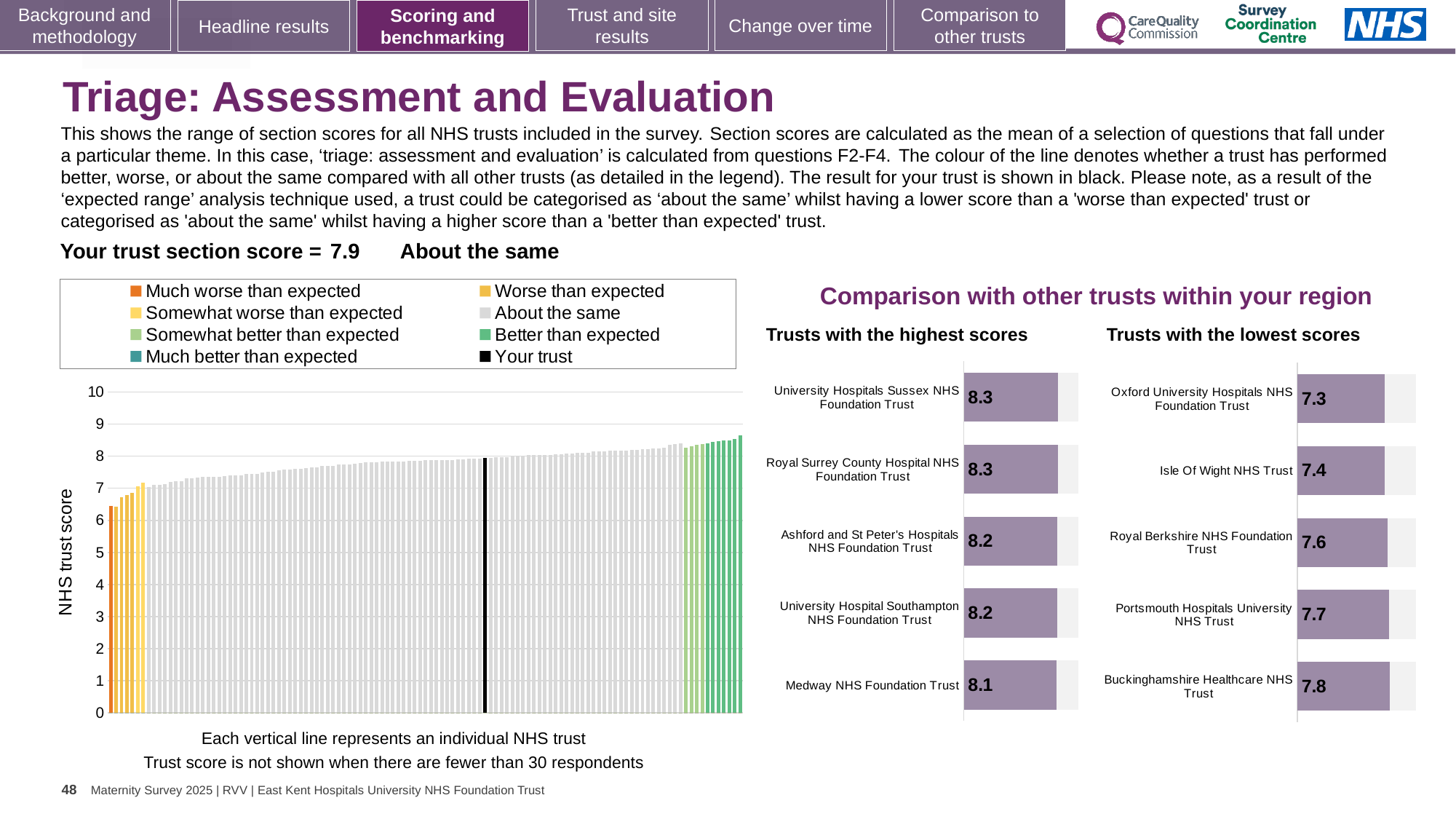
What kind of chart is the 'Trusts with the lowest scores' chart? Bar chart In the 'Trusts with the lowest scores' chart, what is the score for Oxford University Hospitals NHS Foundation Trust? 7.3 How many trusts are shown in the 'Trusts with the highest scores' chart? 5 In the 'Trusts with the lowest scores' chart, which has the larger score: Royal Berkshire NHS Foundation Trust or Portsmouth Hospitals University NHS Trust? Portsmouth Hospitals University NHS Trust In the left-hand chart of NHS trust scores, is the value of the leftmost (lowest) bar greater or less than 7? less In the 'Trusts with the lowest scores' chart, which trust has the lowest score? Oxford University Hospitals NHS Foundation Trust In the 'Trusts with the highest scores' chart, what is the score for Medway NHS Foundation Trust? 8.1 In the 'Trusts with the lowest scores' chart, what is the difference between the scores of Buckinghamshire Healthcare NHS Trust and Oxford University Hospitals NHS Foundation Trust? 0.5 In the 'Trusts with the lowest scores' chart, which trust has the highest score? Buckinghamshire Healthcare NHS Trust In the 'Trusts with the highest scores' chart, what is the difference between the scores of University Hospitals Sussex NHS Foundation Trust and Medway NHS Foundation Trust? 0.2 How many entries does the legend of the left-hand chart list? 8 In the left-hand chart of NHS trust scores, do the bars rise or fall from left to right? Rise